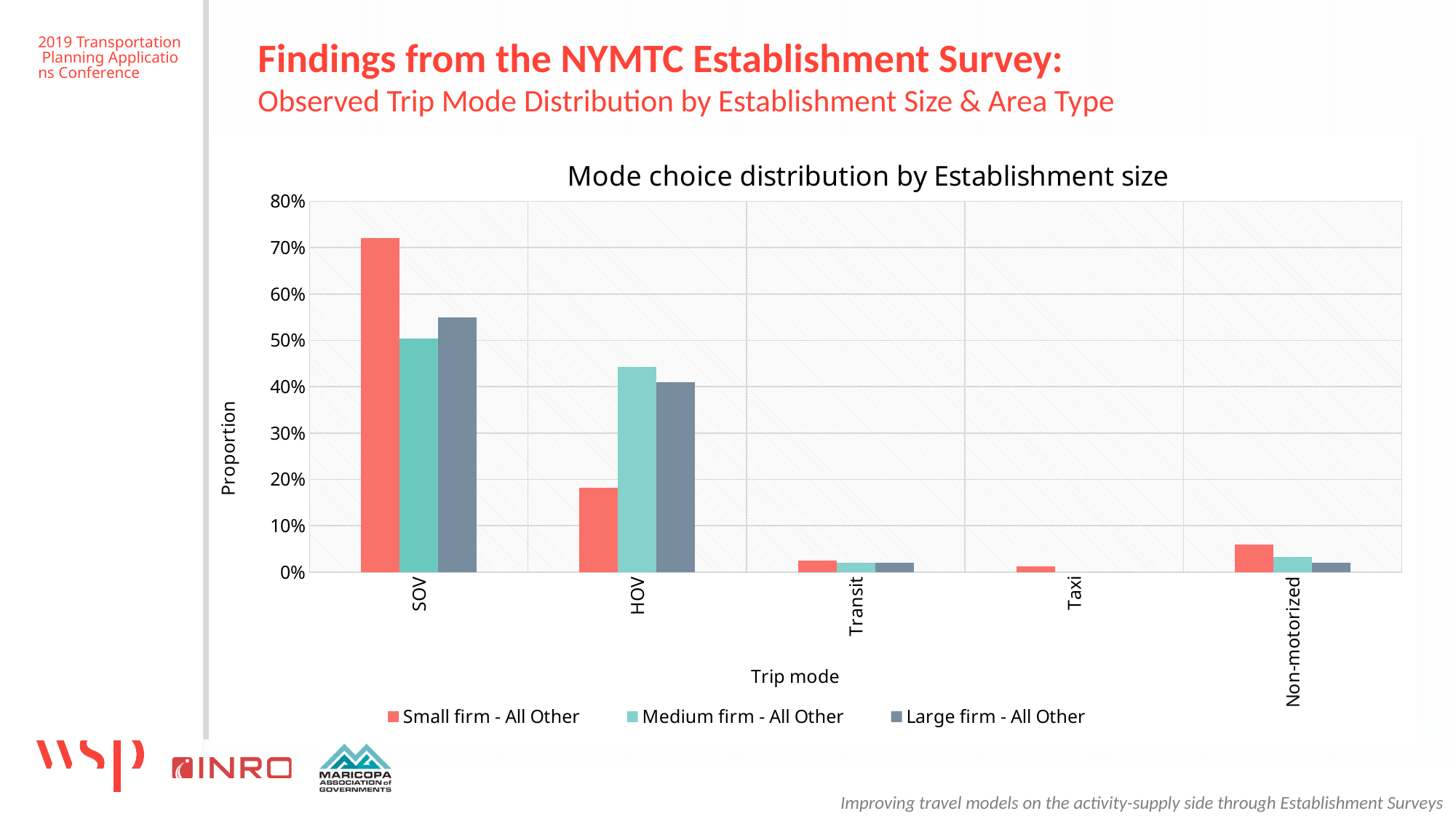
For HOV, which is larger: Small firm - All Other or Medium firm - All Other? Medium firm - All Other Is the value for Small firm - All Other at SOV greater or less than 70%? greater How many series does the legend list? 3 How many trip mode categories are shown on the x axis? 5 For SOV, which is larger: Medium firm - All Other or Large firm - All Other? Large firm - All Other What kind of chart is shown on the slide? bar chart Is the value for Small firm - All Other at HOV greater or less than 20%? less Is the value for Large firm - All Other at SOV greater or less than 50%? greater Which trip mode has the highest proportion for Medium firm - All Other? SOV Which trip mode has the highest proportion for Small firm - All Other? SOV What is the title of the chart? Mode choice distribution by Establishment size